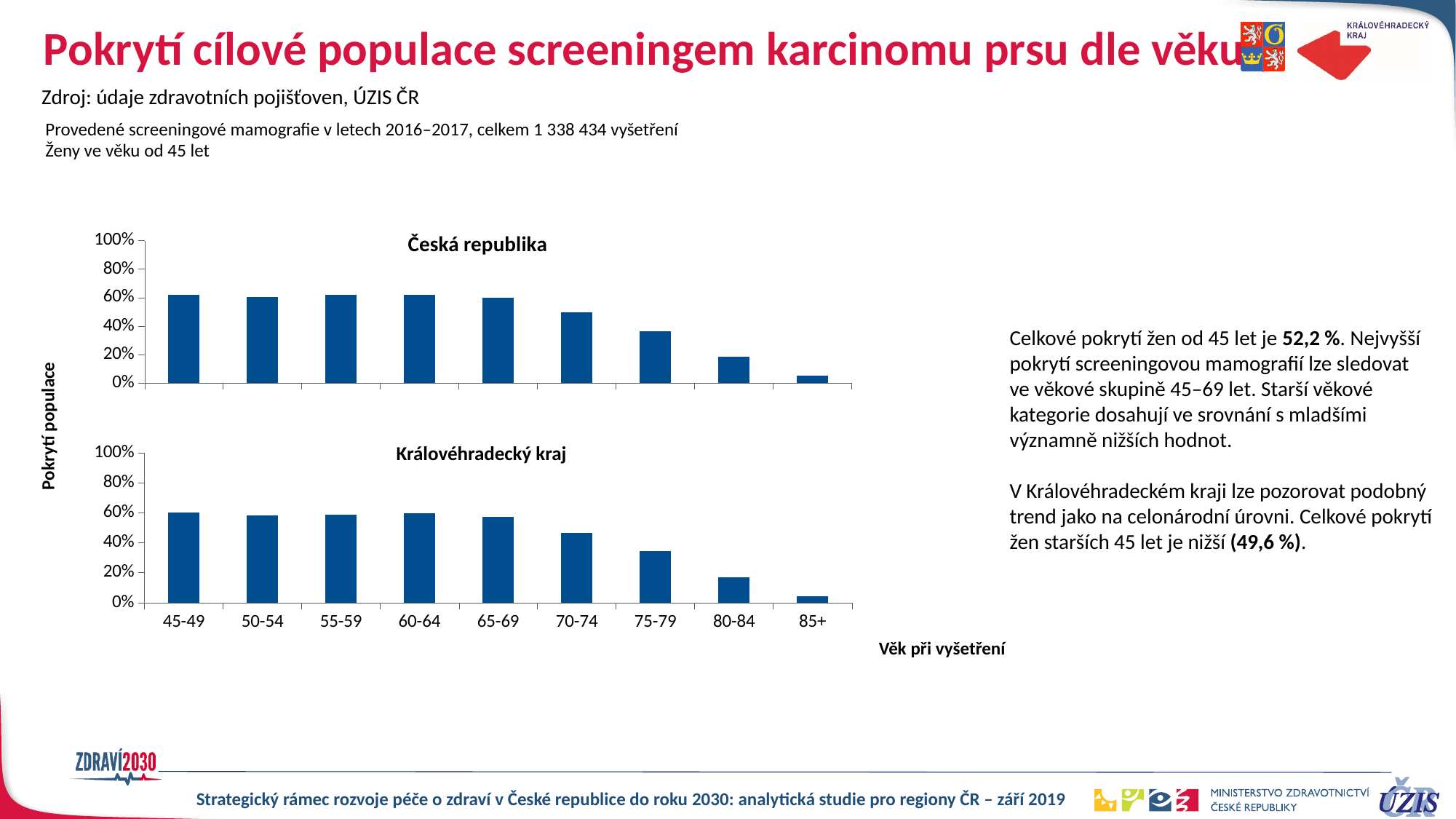
In the Česká republika chart, which age group has the lowest coverage? 85+ What is the title of the lower chart on the slide? Královéhradecký kraj In the Královéhradecký kraj chart, which is larger, the value for 80-84 or the value for 85+? 80-84 In the Česká republika chart, is the value for 75-79 greater or less than 40%? less In the Královéhradecký kraj chart, do the values generally rise or fall from the youngest to the oldest age group? fall In the Královéhradecký kraj chart, is the value for 80-84 greater or less than 20%? less In the Královéhradecký kraj chart, which age group has the lowest coverage? 85+ In the Česká republika chart, is the value for 70-74 greater or less than 40%? greater In the Česká republika chart, which is larger, the value for 70-74 or the value for 75-79? 70-74 What kind of chart is the Česká republika chart? bar chart How many age categories are shown on the x axis of the Královéhradecký kraj chart? 9